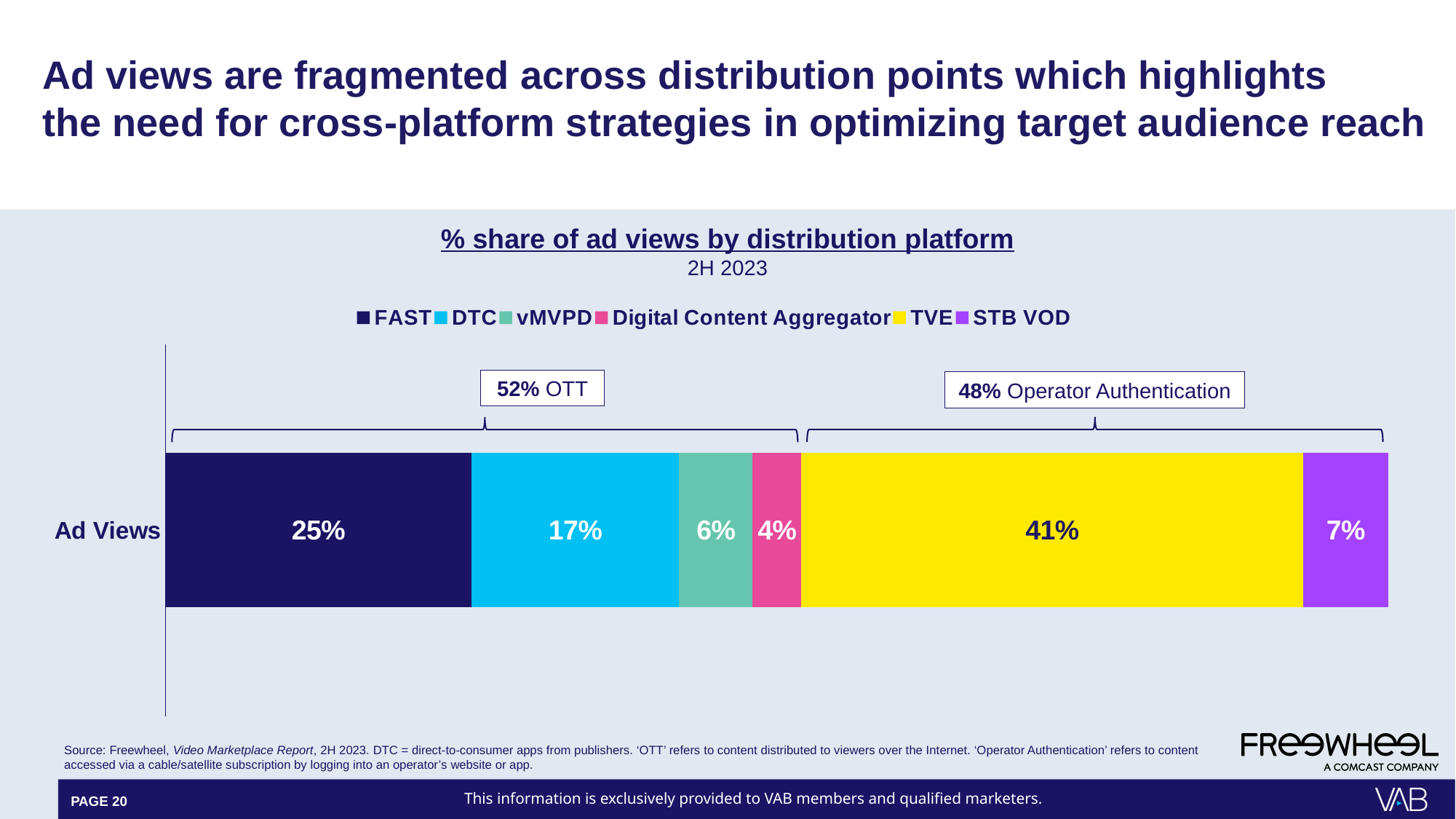
What share of ad views does STB VOD account for? 7% What kind of chart is shown on the slide? Stacked bar chart Which distribution platform has the smallest share of ad views? Digital Content Aggregator Which has a larger share of ad views, DTC or vMVPD? DTC What is the difference between the TVE share and the FAST share of ad views? 16% How many series does the legend list? 6 What share of ad views does FAST account for? 25% What share of ad views does DTC account for? 17% Which distribution platform has the largest share of ad views? TVE What is the combined share of ad views for the OTT platforms (FAST, DTC, vMVPD and Digital Content Aggregator)? 52% What time period does the chart cover? 2H 2023 What share of ad views does TVE account for? 41%